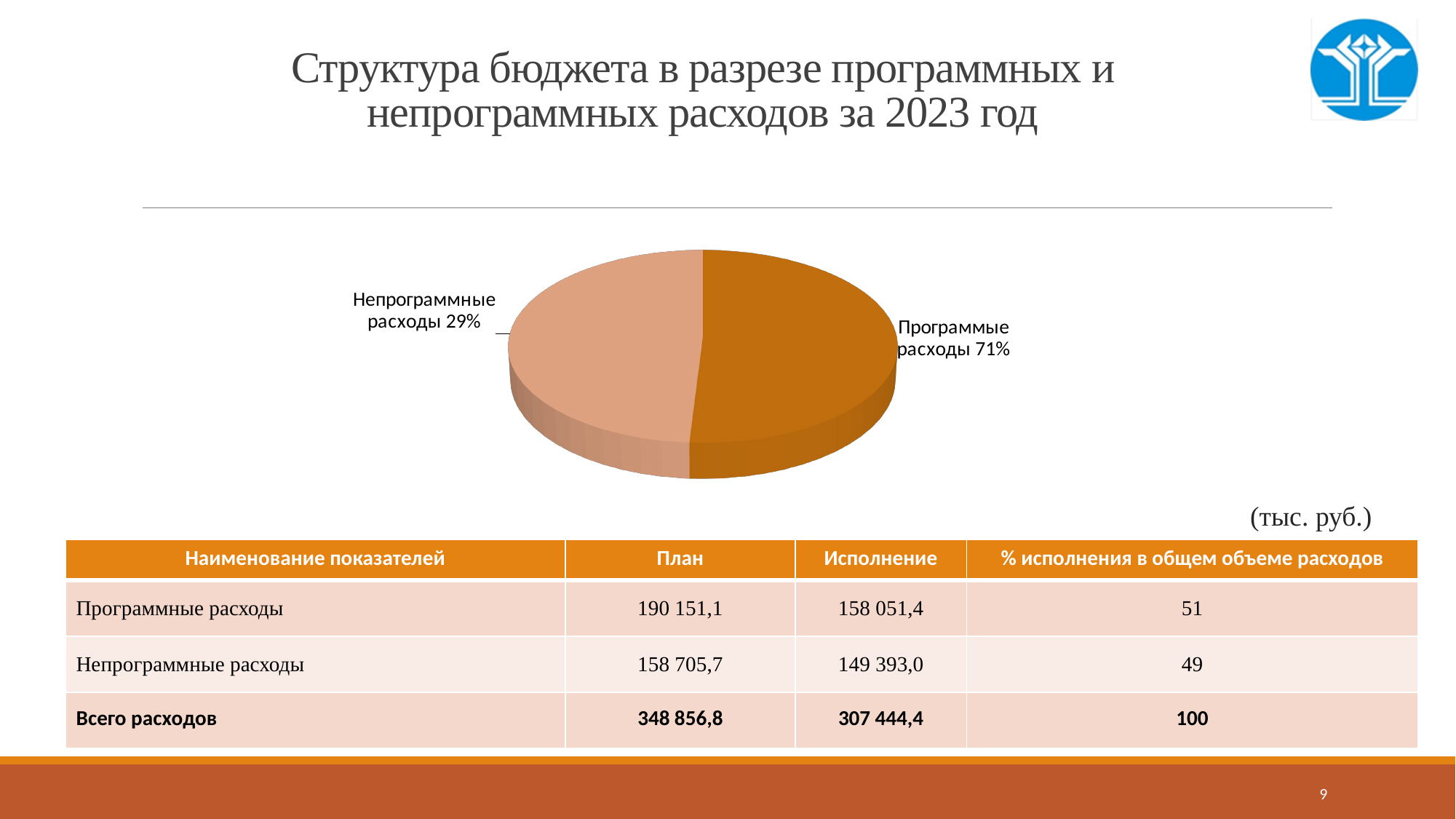
Which slice of the pie chart is the largest? Программные расходы Which is larger in the pie chart: Программные расходы or Непрограммные расходы? Программные расходы What share of the pie does Непрограммные расходы have? 29% What share of the pie does Программные расходы have? 71% What colour is the Программные расходы slice in the pie chart? dark orange Which slice of the pie chart is the smallest? Непрограммные расходы Is the share for Программные расходы greater or less than 50%? greater What kind of chart is shown on the slide? pie chart By how many percentage points does the Программные расходы slice exceed the Непрограммные расходы slice? 42 How many slices does the pie chart have? 2 Is the share for Непрограммные расходы greater or less than 50%? less What is the title of the slide containing the pie chart? Структура бюджета в разрезе программных и непрограммных расходов за 2023 год